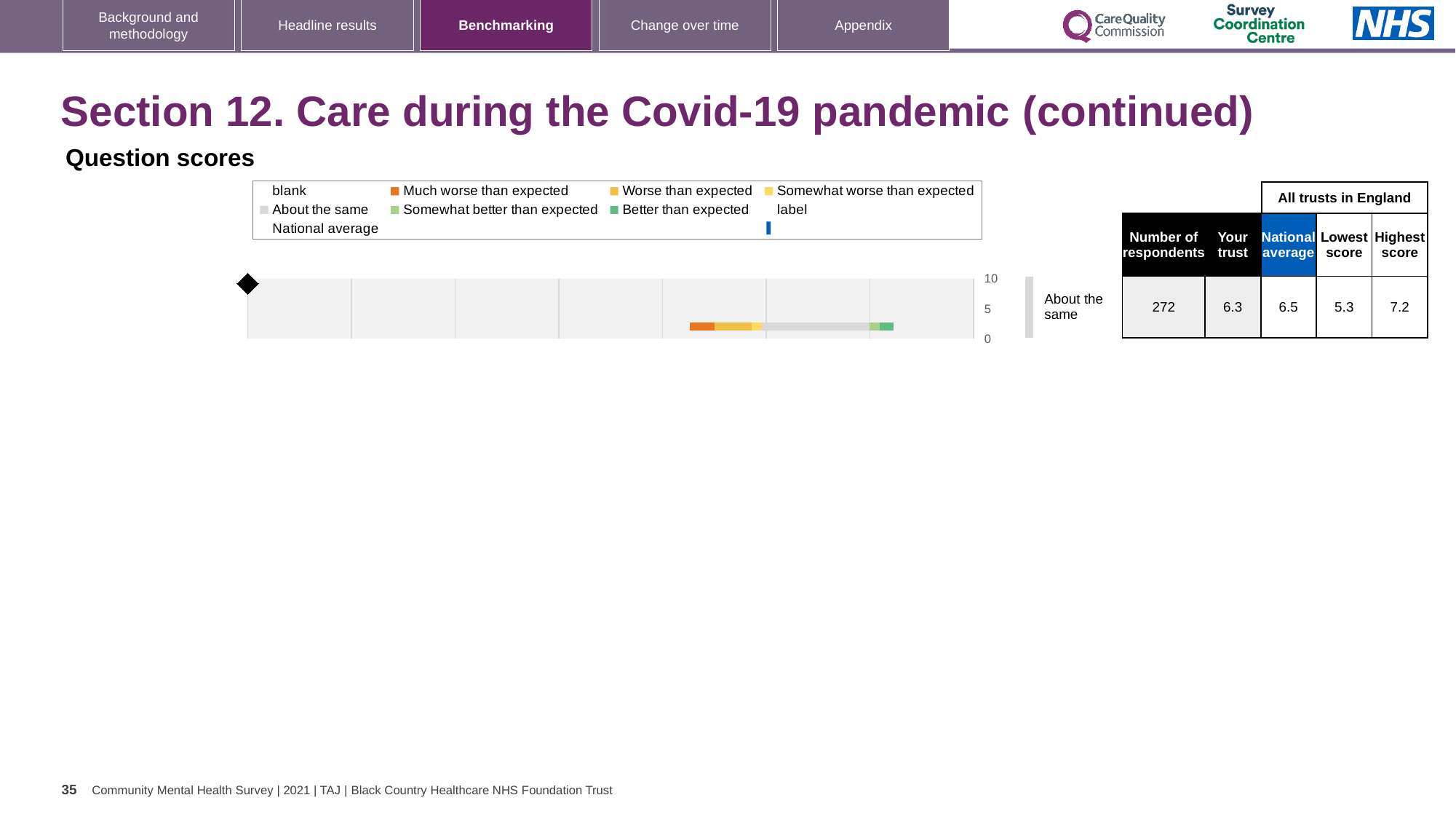
What is the Highest score among all trusts in England? 7.2 Which legend entry is shown in orange? Much worse than expected What is the difference between the National average and the 'Your trust' score? 0.2 Which is larger, the 'Your trust' score or the National average? National average What is the difference between the Highest score and the Lowest score among all trusts in England? 1.9 What is the 'Your trust' score shown next to the chart? 6.3 How many respondents are shown for this question? 272 Which benchmarking category is the trust's result labelled as? About the same What is the highest value shown on the chart's numeric axis? 10 What is the Lowest score among all trusts in England? 5.3 What kind of chart is shown under 'Question scores'? bar chart What is the National average score shown next to the chart? 6.5